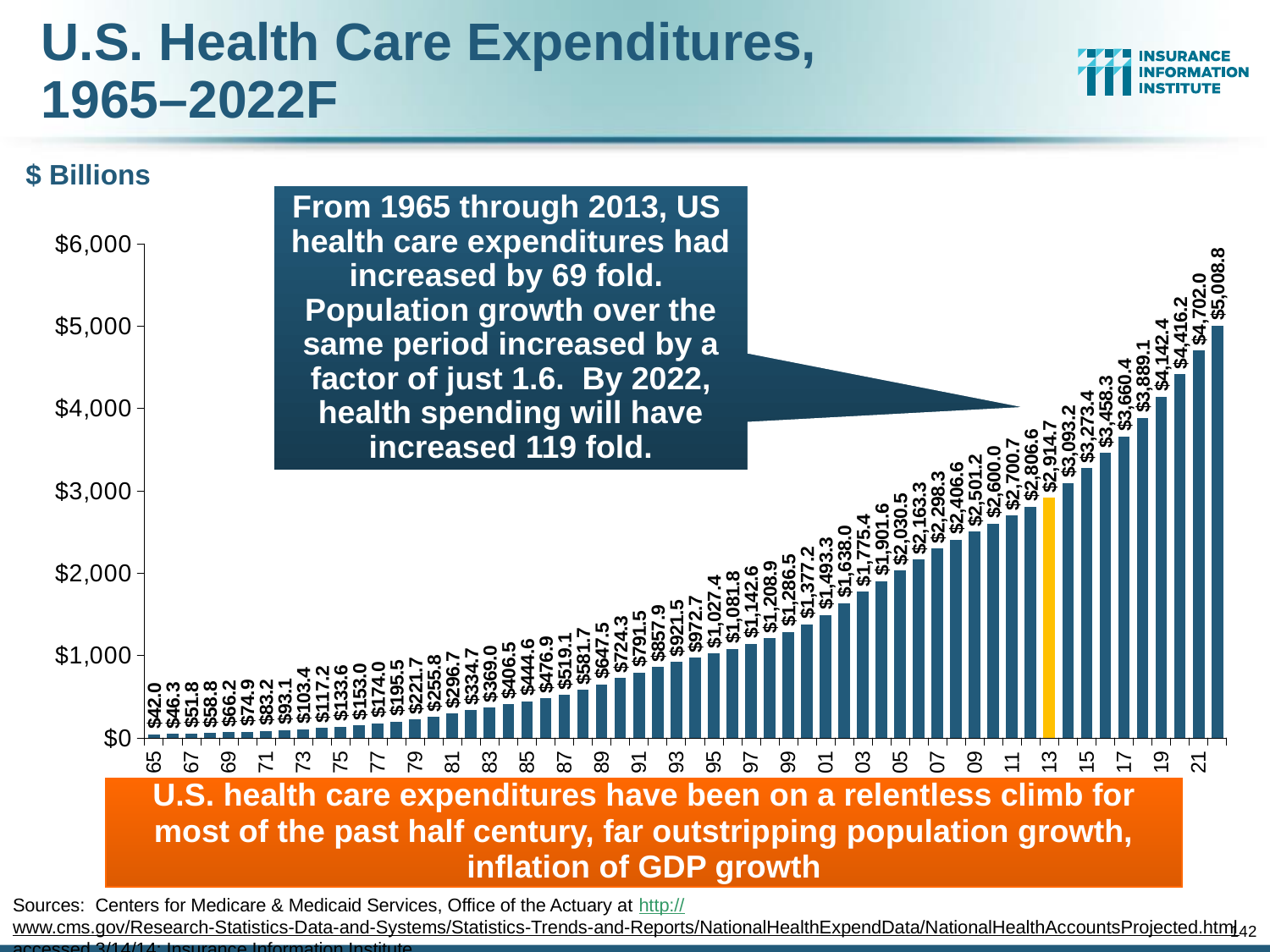
What is the value shown for 2013, the highlighted bar? $2,914.7 What type of chart is shown on the slide? bar chart What unit is stated for the values on the chart? $ Billions Is the value for 2009 greater or less than $2,000? greater Do the values generally rise or fall from 1965 to 2022? rise Which year has the lowest value on the chart? 1965 What value does the chart show for the year 2001? $1,493.3 Which is larger, the value for 2013 or the value for 2011? 2013 What is the forecast value shown for 2022, the last bar on the chart? $5,008.8 Which year has the highest value on the chart? 2022 What was U.S. health care expenditure in 1965, according to the chart? $42.0 What is the difference between the 2022 value and the 1965 value? $4,966.8